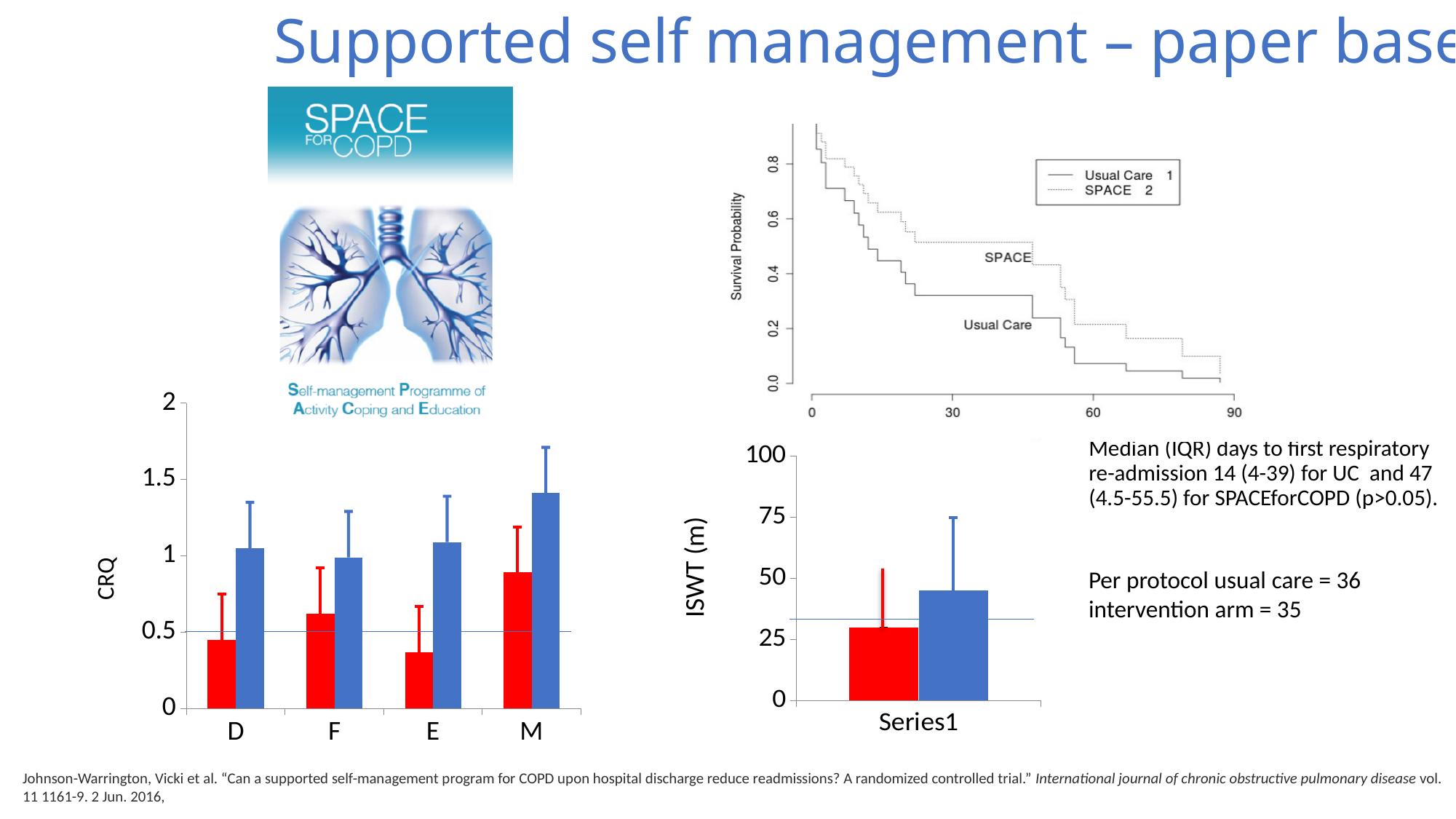
What kind of chart is the CRQ chart at the bottom left of the slide? bar chart What kind of chart is the ISWT (m) chart on the right side of the slide? bar chart How many series does the legend of the survival probability chart list? 2 How many categories are shown on the x axis of the CRQ bar chart? 4 In the CRQ bar chart, for category M, which bar is taller, the red one or the blue one? blue In the CRQ bar chart, which category has the tallest red bar? M In the survival probability chart, do the curves rise or fall as you move along the x axis? fall In the CRQ bar chart, is the red bar for category E greater or less than 0.5? less In the CRQ bar chart, which category has the tallest blue bar? M In the ISWT (m) bar chart, which bar is taller, the red one or the blue one? blue In the CRQ bar chart, is the blue bar for category M greater or less than 1? greater In the ISWT (m) bar chart, is the blue bar greater or less than 50? less